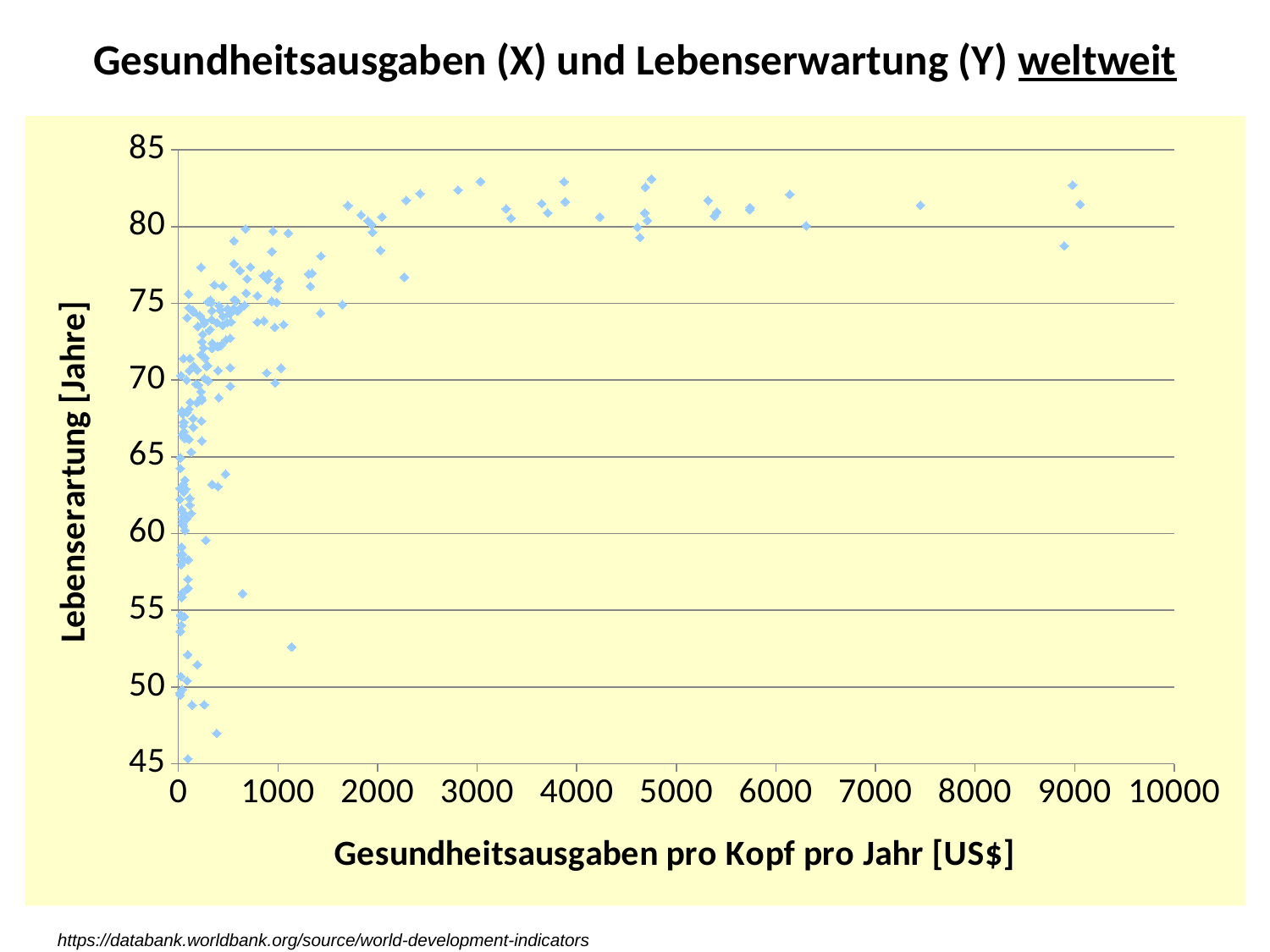
What kind of chart is shown on the slide? Scatter plot Are the life expectancy values of the points with health expenditure above 2000 US$ greater or less than 75 years? greater Is the life expectancy of the points with health expenditure around 9000 US$ greater or less than 75 years? greater What is the title of the x axis? Gesundheitsausgaben pro Kopf pro Jahr [US$] Do any points on the chart have a life expectancy above 85 years? No As health expenditure per capita increases along the x axis, does life expectancy generally rise or fall? Rise What is the title of the y axis? Lebenserartung [Jahre] In which range of health expenditure are most of the points concentrated: below 1000 US$ or above 5000 US$? Below 1000 US$